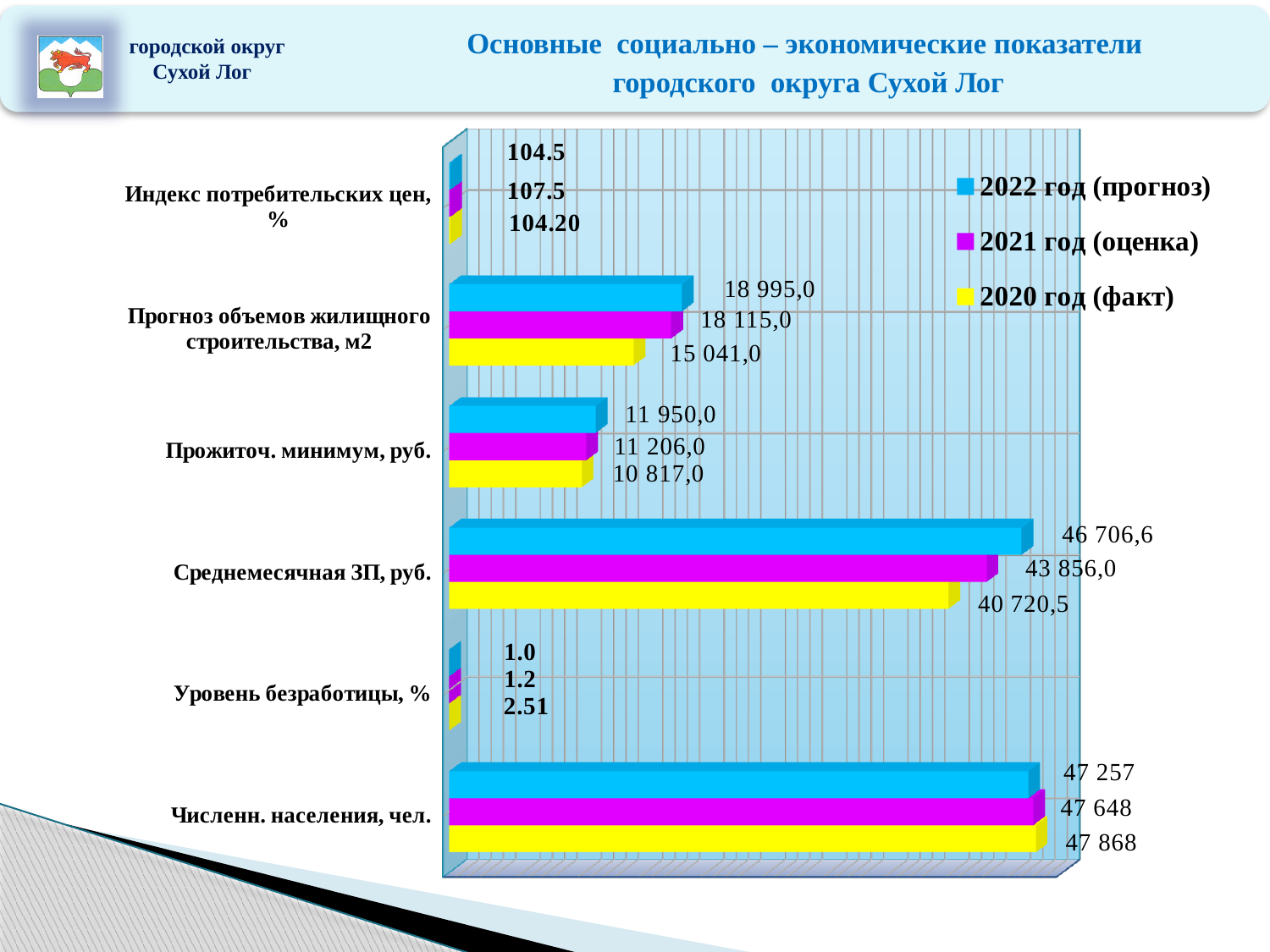
Which year has the lowest value for Прогноз объемов жилищного строительства, м2? 2020 год (факт) What is the 2022 год (прогноз) value for Среднемесячная ЗП, руб.? 46 706,6 What is the difference between the 2022 год (прогноз) and 2020 год (факт) values for Прогноз объемов жилищного строительства, м2? 3 954,0 What is the 2021 год (оценка) value for Прожиточ. минимум, руб.? 11 206,0 Which year has the highest value for Численн. населения, чел.? 2020 год (факт) Which is larger for Уровень безработицы, %: the 2021 год (оценка) value or the 2022 год (прогноз) value? 2021 год (оценка) How many series does the legend list? 3 What kind of chart is shown on the slide? Bar chart What is the 2020 год (факт) value for Численн. населения, чел.? 47 868 What is the 2021 год (оценка) value for Индекс потребительских цен, %? 107.5 What is the 2020 год (факт) value for Уровень безработицы, %? 2.51 How many categories are shown on the chart? 6